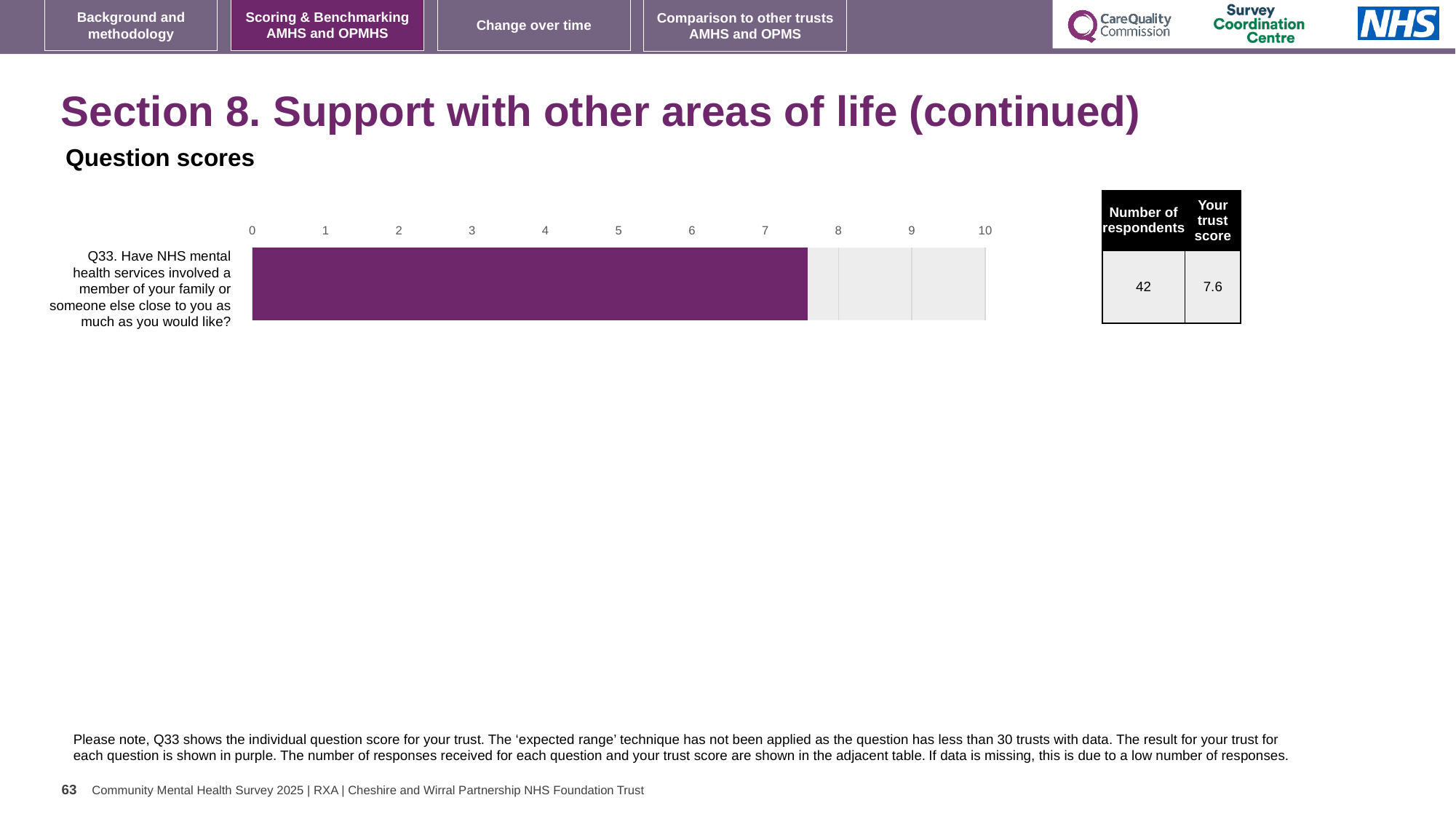
Is the value of the bar for Q33 greater or less than 8? less Is the value of the bar for Q33 greater or less than 7? greater What is the maximum value shown on the chart's axis? 10 How many questions (categories) are plotted in the chart? 1 How many respondents answered Q33 according to the table? 42 What type of chart is shown on the slide? bar chart What is the trust score for Q33 shown in the adjacent table? 7.6 Which question number is plotted in the chart? Q33 What colour is the bar representing the trust's result for Q33? purple